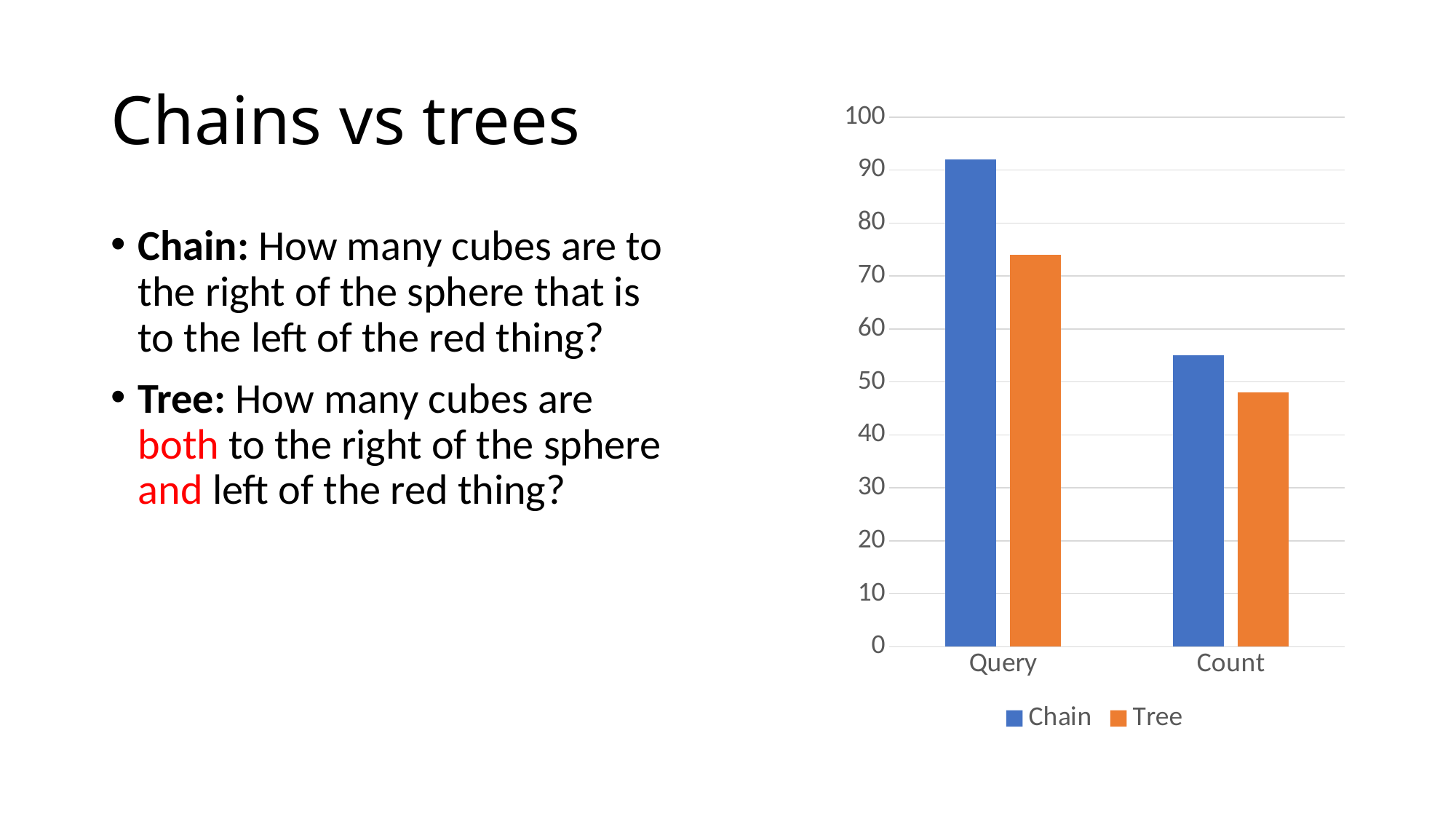
How many series does the chart legend list? 2 Which category has the lowest Tree value? Count Which series does the legend show in orange? Tree What kind of chart is shown on the slide? bar chart Which category has the highest Chain value? Query Which series does the legend show in blue? Chain For the Query category, which series has the larger value, Chain or Tree? Chain Is the Chain value for Query greater or less than 90? greater Is the Tree value for Count greater or less than 50? less Is the Chain value for Count greater or less than 60? less How many categories are shown on the x axis of the chart? 2